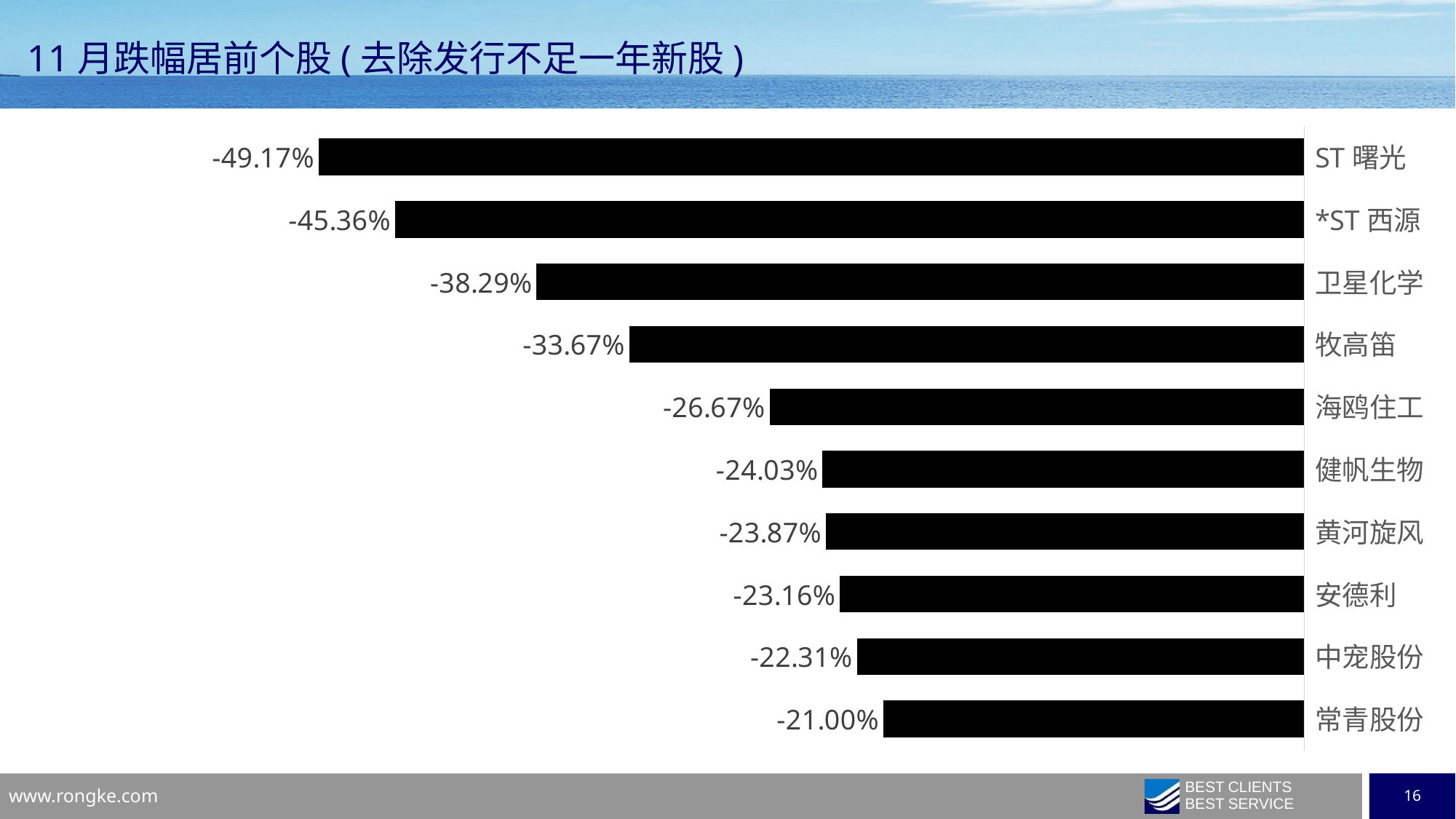
What is the value for 常青股份? -21.00% What is the title of the slide? 11 月跌幅居前个股（去除发行不足一年新股） How many stocks are shown in the chart? 10 What is the difference between the values for 卫星化学 and 牧高笛? 4.62% Which stock has the smallest decline (highest value)? 常青股份 What is the value for 牧高笛? -33.67% Which stock has the largest decline (lowest value)? ST 曙光 What is the difference between the values for ST 曙光 and *ST 西源? 3.81% Which has a larger decline, 海鸥住工 or 健帆生物? 海鸥住工 What is the value for 黄河旋风? -23.87% What is the value for ST 曙光? -49.17% What kind of chart is shown on the slide? bar chart